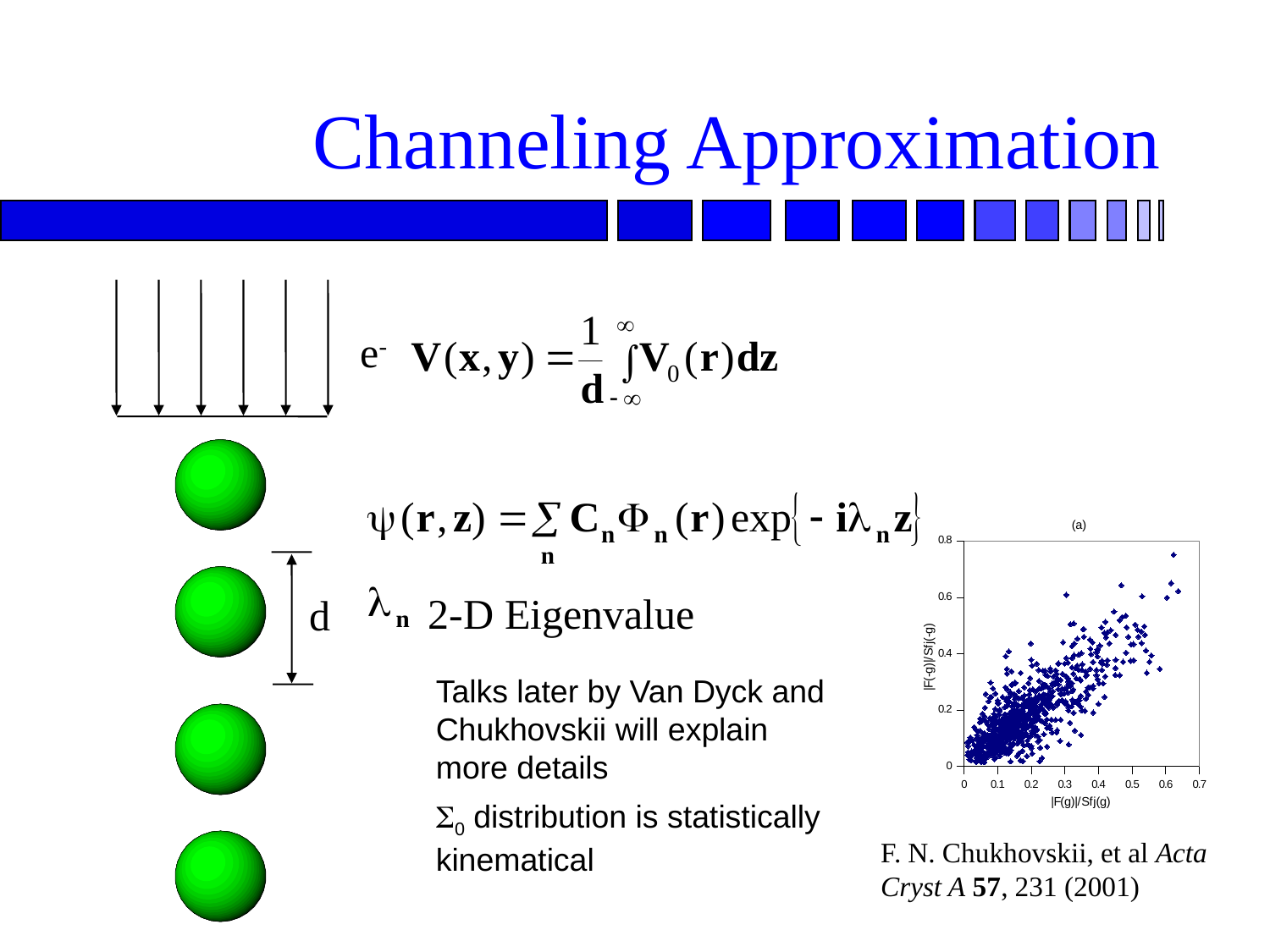
In the scatter chart, do the y values generally rise or fall as the x value increases? rise What is the label of the x axis of the scatter chart? |F(g)|/Sfj(g) What kind of chart is shown on the slide? scatter chart What is the highest tick value shown on the x axis of the scatter chart? 0.7 What is the title printed above the scatter chart? (a)